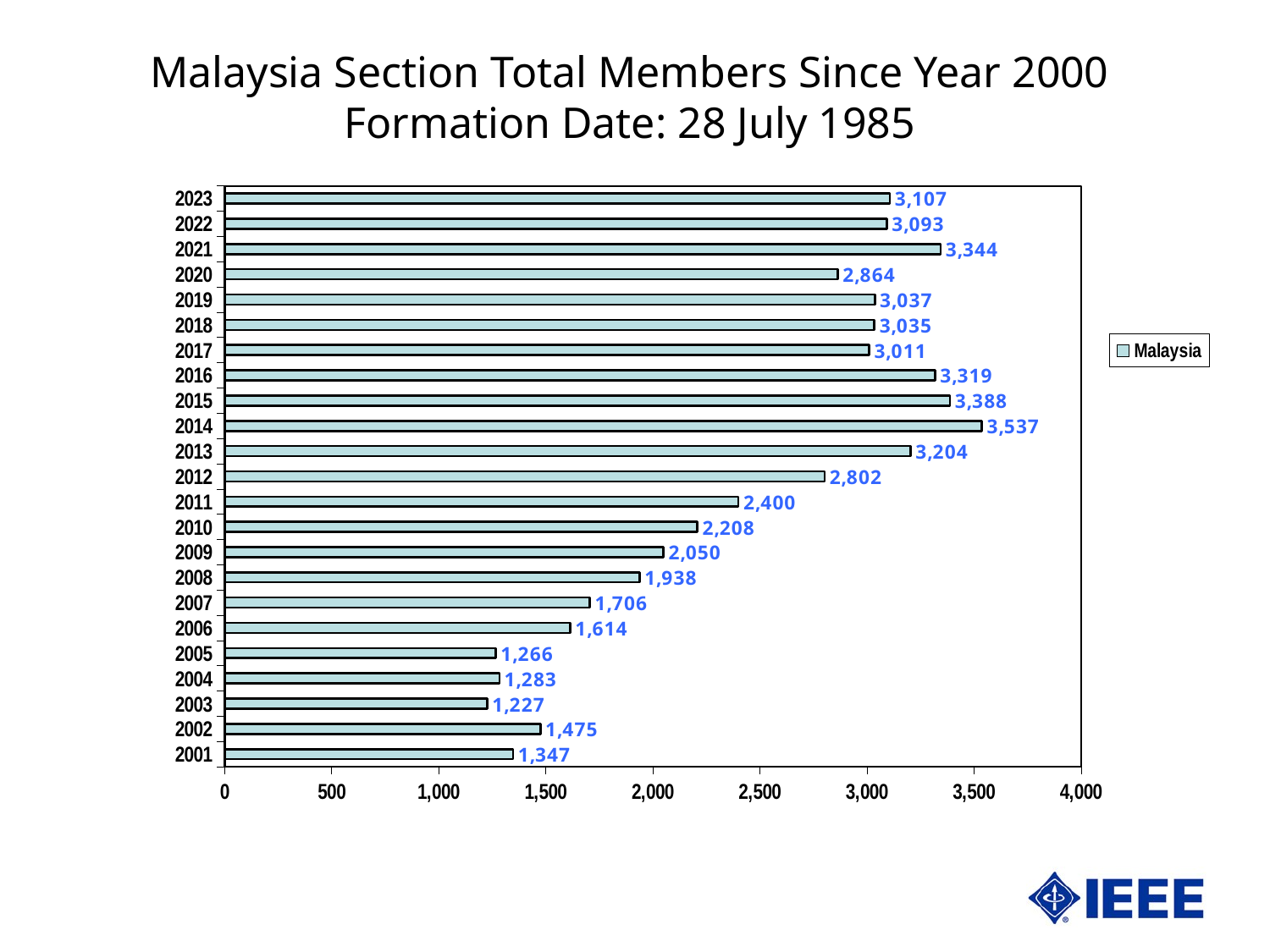
How many series does the legend list? 1 What is the difference between the values for 2014 and 2013? 333 Which year has the highest value? 2014 What is the value for 2001? 1,347 How many years are shown in the chart? 23 What kind of chart is shown on the slide? bar chart What is the value for 2011? 2,400 What is the value for 2023? 3,107 Which year has the lowest value? 2003 Is the value for 2012 greater or less than 2,500? greater What is the difference between the values for 2023 and 2022? 14 Which is larger, the value for 2021 or the value for 2020? 2021